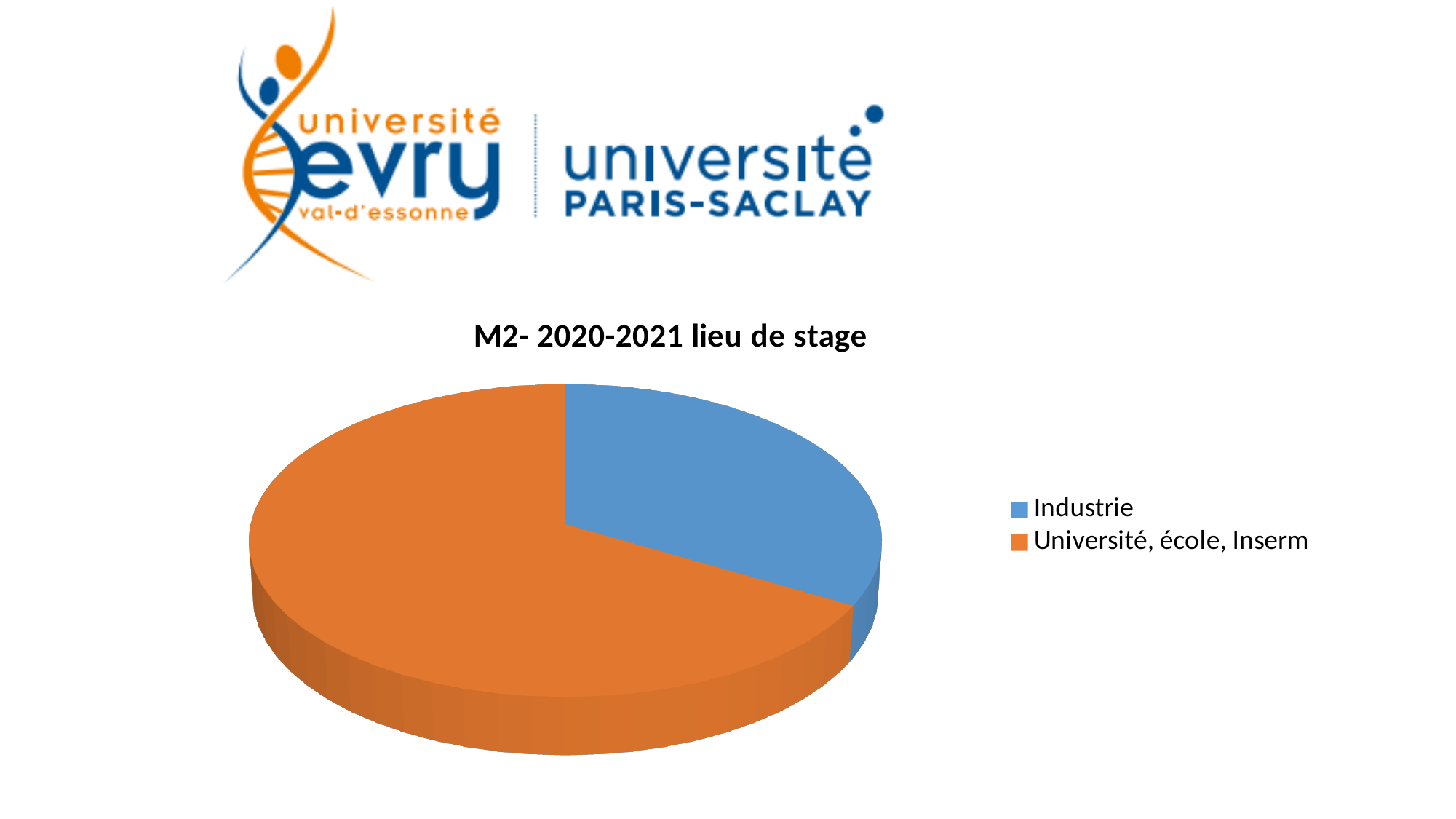
Which category has the smallest slice of the pie? Industrie How many entries does the legend list? 2 What kind of chart is shown on the slide? pie chart Which slice is larger, Industrie or Université, école, Inserm? Université, école, Inserm How many categories does the pie chart show? 2 What colour is the Industrie slice? blue What is the title of the chart? M2- 2020-2021 lieu de stage Which category has the largest slice of the pie? Université, école, Inserm